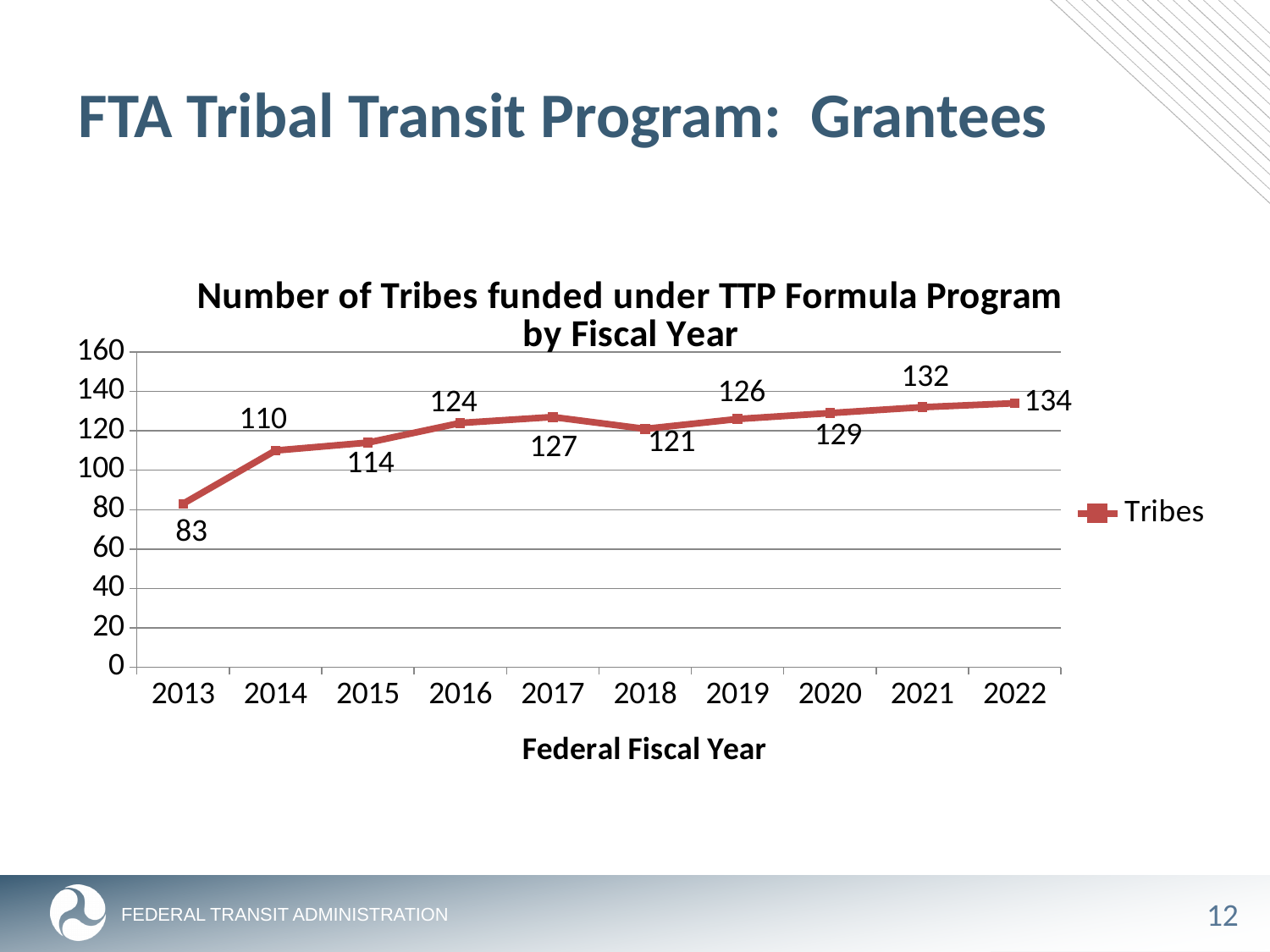
What is the name of the series listed in the legend? Tribes How many fiscal years are plotted on the chart? 10 How many tribes were funded under the TTP Formula Program in 2013? 83 Which fiscal year has the lowest number of tribes funded? 2013 What is the difference between the values for 2017 and 2018? 6 What is the value for 2022? 134 What kind of chart is shown on the slide? Line chart What is the difference between the values for 2014 and 2013? 27 What is the value for 2018? 121 Which fiscal year has the highest number of tribes funded? 2022 Is the value for 2015 greater or less than 100? greater Which is larger, the value for 2016 or the value for 2018? 2016